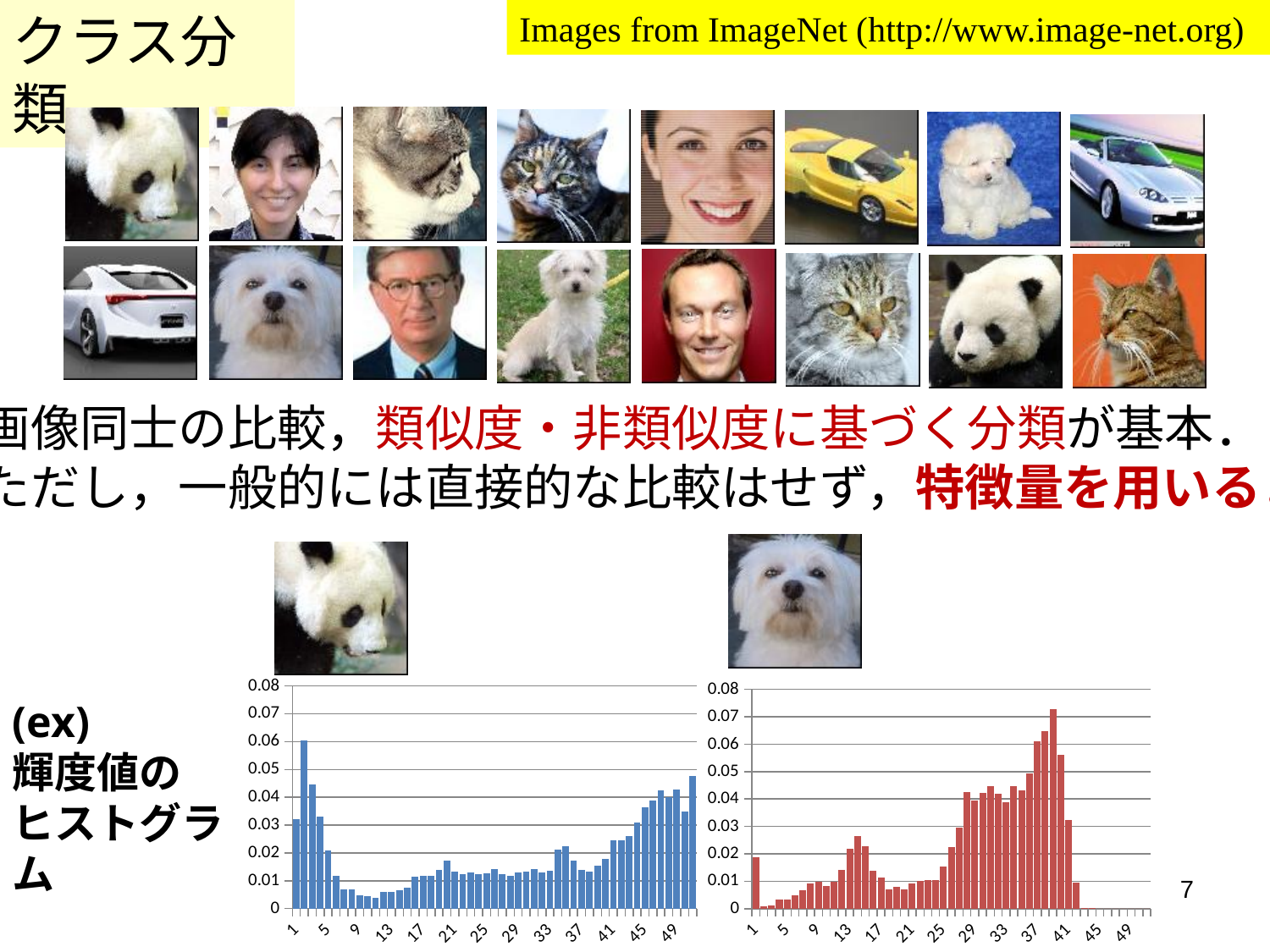
In the right (red) chart, is the value for bin 1 greater or less than 0.03? less In the left (blue) chart, is the value for bin 9 greater or less than 0.01? less In the left (blue) chart, which bin has the higher value, bin 1 or bin 9? bin 1 What colour are the bars in the chart below the dog image? red In the left (blue) chart, do the values rise or fall from bin 1 to bin 9? fall What kind of chart is the left chart below the panda image? bar chart What is the maximum value shown on the y axis of the right (red) chart? 0.08 In the left (blue) chart, which bin has the highest value? bin 2 In the left (blue) chart, is the value for bin 1 greater or less than 0.05? less What kind of chart is the right chart below the dog image? bar chart In the right (red) chart, which bin has the higher value, bin 37 or bin 13? bin 37